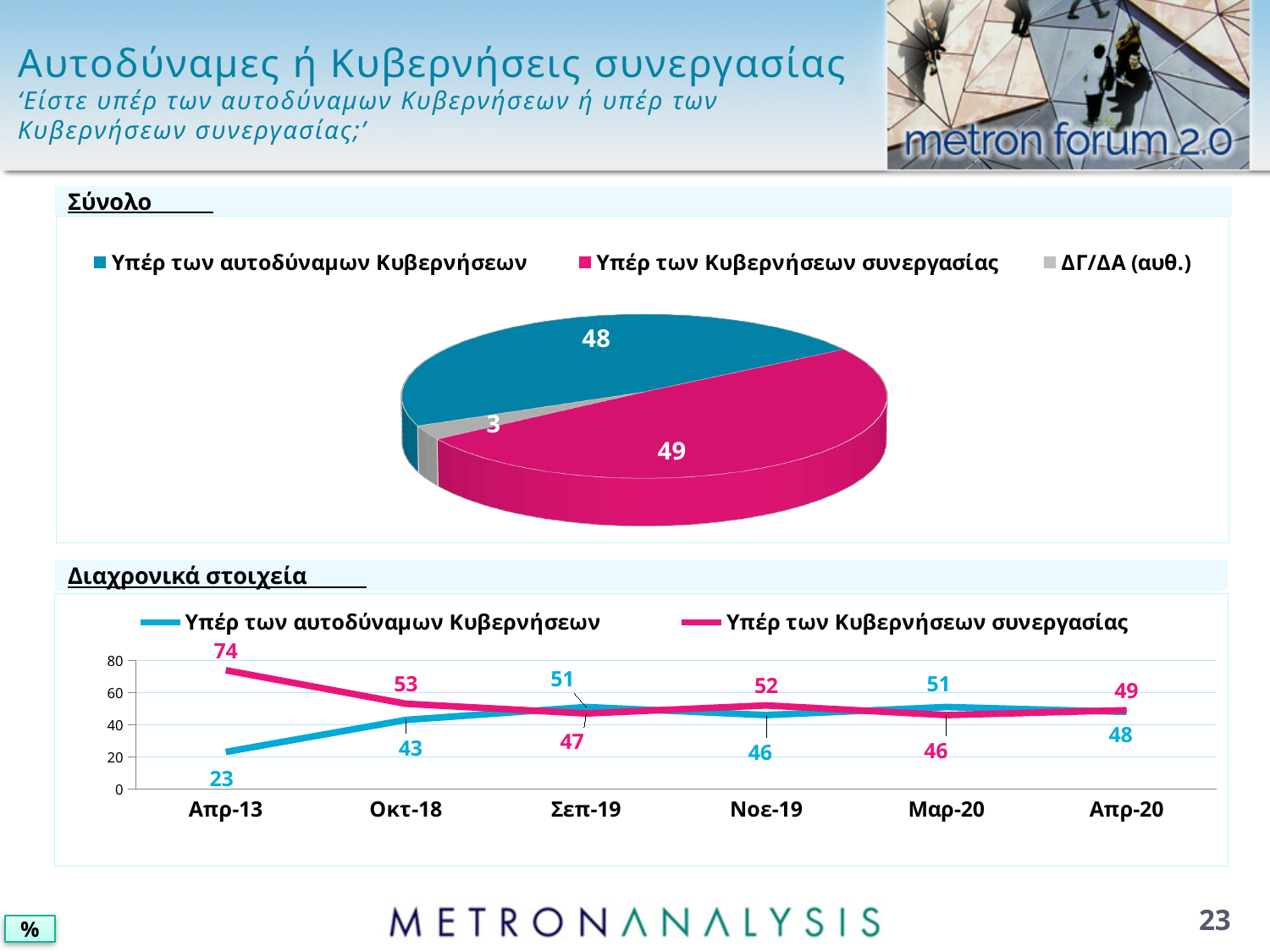
In the pie chart under 'Σύνολο', what is the value for 'ΔΓ/ΔΑ (αυθ.)'? 3 What kind of chart is shown under 'Σύνολο'? Pie chart In the pie chart under 'Σύνολο', what is the value for 'Υπέρ των Κυβερνήσεων συνεργασίας'? 49 In the line chart under 'Διαχρονικά στοιχεία', does 'Υπέρ των Κυβερνήσεων συνεργασίας' rise or fall from Απρ-13 to Οκτ-18? Fall In the line chart under 'Διαχρονικά στοιχεία', how many series does the legend list? 2 In the line chart under 'Διαχρονικά στοιχεία', what is the value for 'Υπέρ των Κυβερνήσεων συνεργασίας' at Απρ-13? 74 In the line chart under 'Διαχρονικά στοιχεία', what is the difference between the two series at Απρ-13? 51 In the line chart under 'Διαχρονικά στοιχεία', what is the value for 'Υπέρ των αυτοδύναμων Κυβερνήσεων' at Νοε-19? 46 In the line chart under 'Διαχρονικά στοιχεία', which series has the higher value at Οκτ-18? Υπέρ των Κυβερνήσεων συνεργασίας In the pie chart under 'Σύνολο', how many slices are there? 3 In the pie chart under 'Σύνολο', which category has the smallest slice? ΔΓ/ΔΑ (αυθ.) In the line chart under 'Διαχρονικά στοιχεία', at which date is 'Υπέρ των αυτοδύναμων Κυβερνήσεων' lowest? Απρ-13